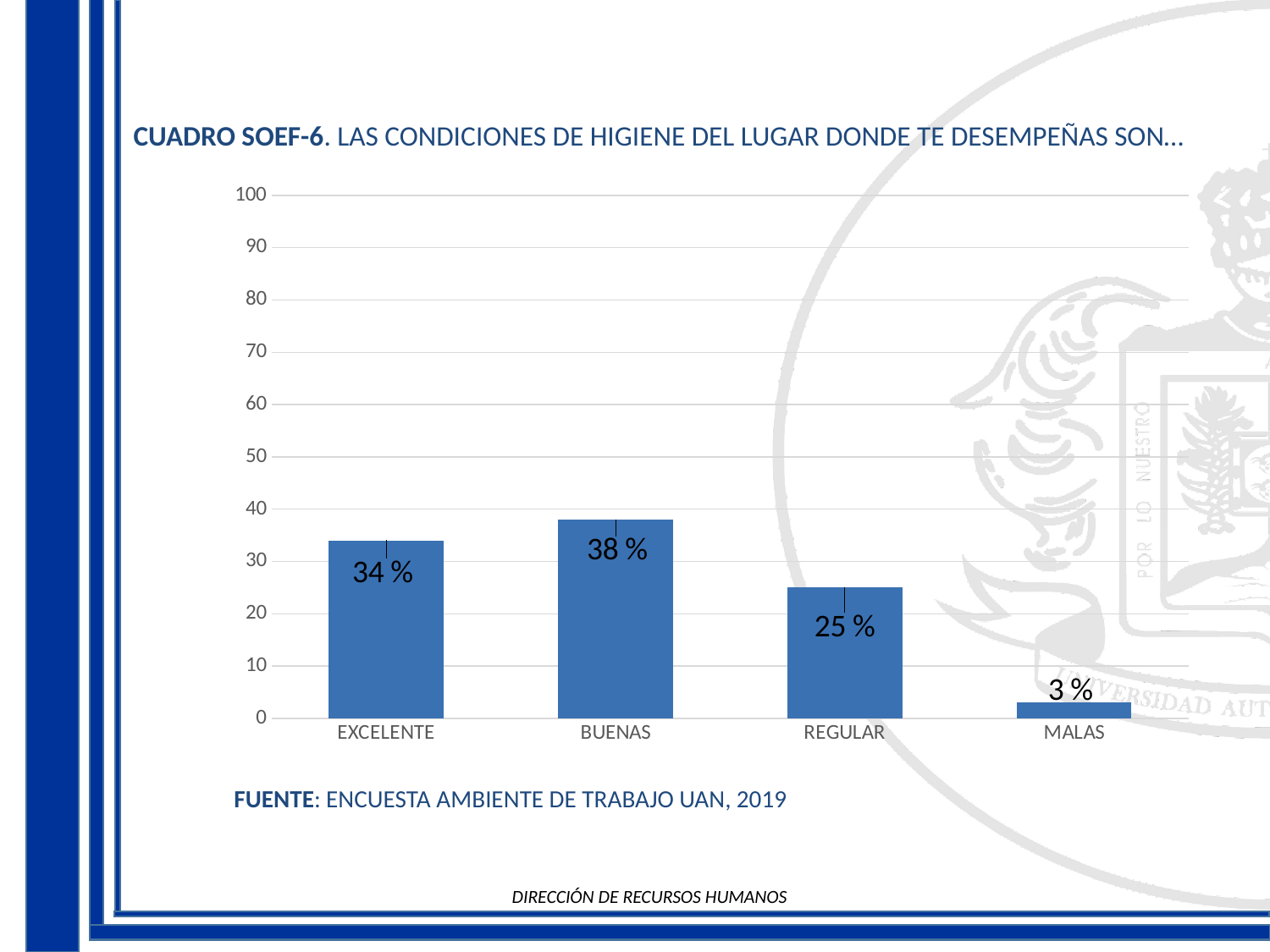
Which category has the highest value? BUENAS How many categories are shown on the x axis? 4 What is the value for MALAS? 3 % What is the difference between the values for REGULAR and MALAS? 22 % Which category has the lowest value? MALAS Which is larger, the value for EXCELENTE or the value for REGULAR? EXCELENTE What kind of chart is shown on the slide? bar chart What is the value for REGULAR? 25 % What is the value for BUENAS? 38 % Is the value for REGULAR greater or less than 30? less What source is cited below the chart? ENCUESTA AMBIENTE DE TRABAJO UAN, 2019 What is the difference between the values for BUENAS and EXCELENTE? 4 %